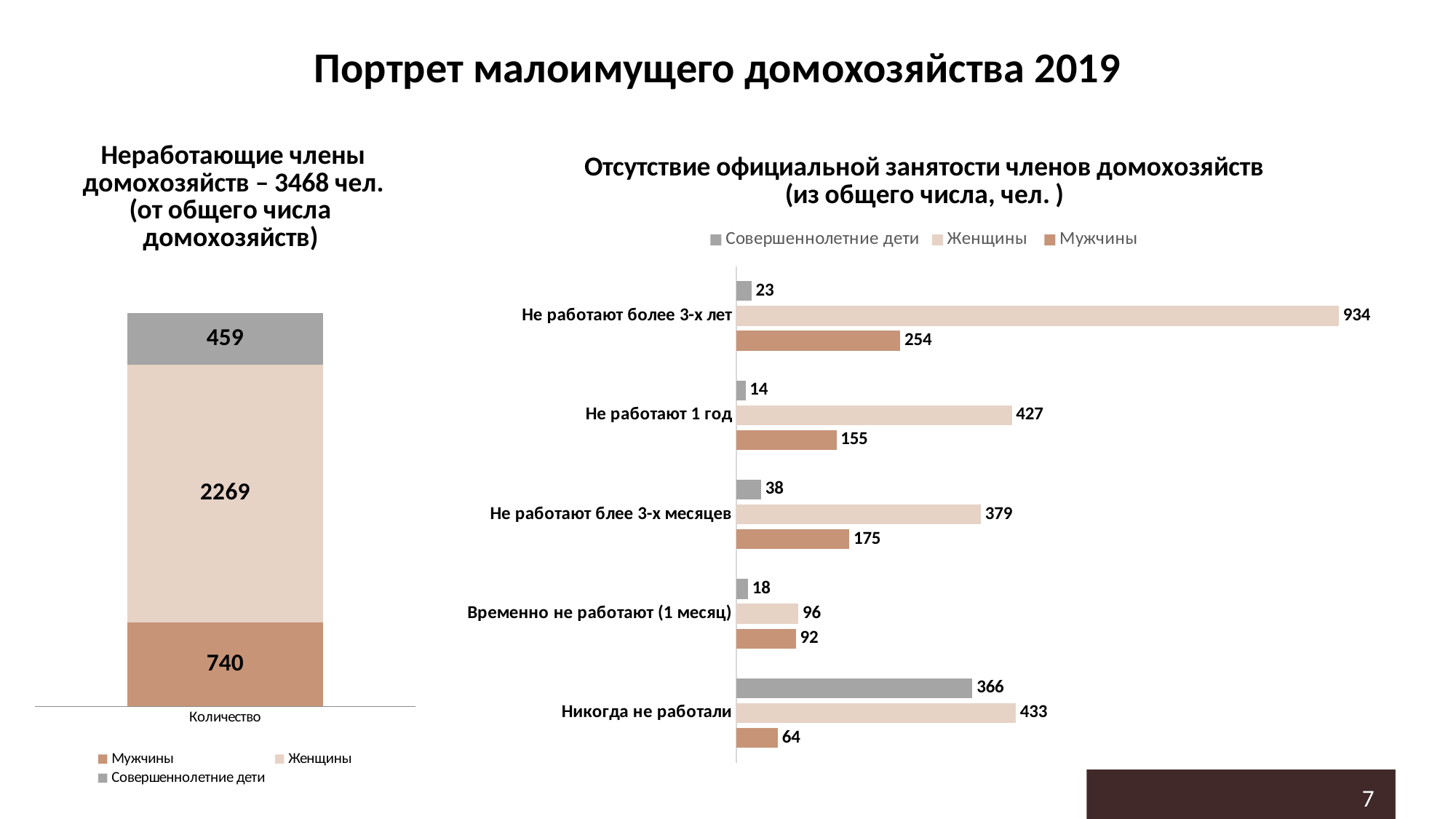
In the right chart (Отсутствие официальной занятости членов домохозяйств), what is the difference between Женщины and Мужчины in the category 'Не работают 1 год'? 272 In the right chart (Отсутствие официальной занятости членов домохозяйств), what is the value for Женщины in the category 'Не работают более 3-х лет'? 934 In the right chart (Отсутствие официальной занятости членов домохозяйств), which is larger in the category 'Временно не работают (1 месяц)': Женщины or Мужчины? Женщины In the right chart (Отсутствие официальной занятости членов домохозяйств), which category has the highest value for Совершеннолетние дети? Никогда не работали In the left chart (Неработающие члены домохозяйств), which segment is the smallest? Совершеннолетние дети What kind of chart is the right chart (Отсутствие официальной занятости членов домохозяйств)? Bar chart In the left chart (Неработающие члены домохозяйств), what is the total of the stacked bar? 3468 In the left chart (Неработающие члены домохозяйств), what is the value for Женщины? 2269 In the right chart (Отсутствие официальной занятости членов домохозяйств), what is the value for Мужчины in the category 'Никогда не работали'? 64 In the right chart (Отсутствие официальной занятости членов домохозяйств), which category has the lowest value for Мужчины? Никогда не работали In the right chart (Отсутствие официальной занятости членов домохозяйств), how many categories are shown? 5 In the left chart (Неработающие члены домохозяйств), how many series does the legend list? 3